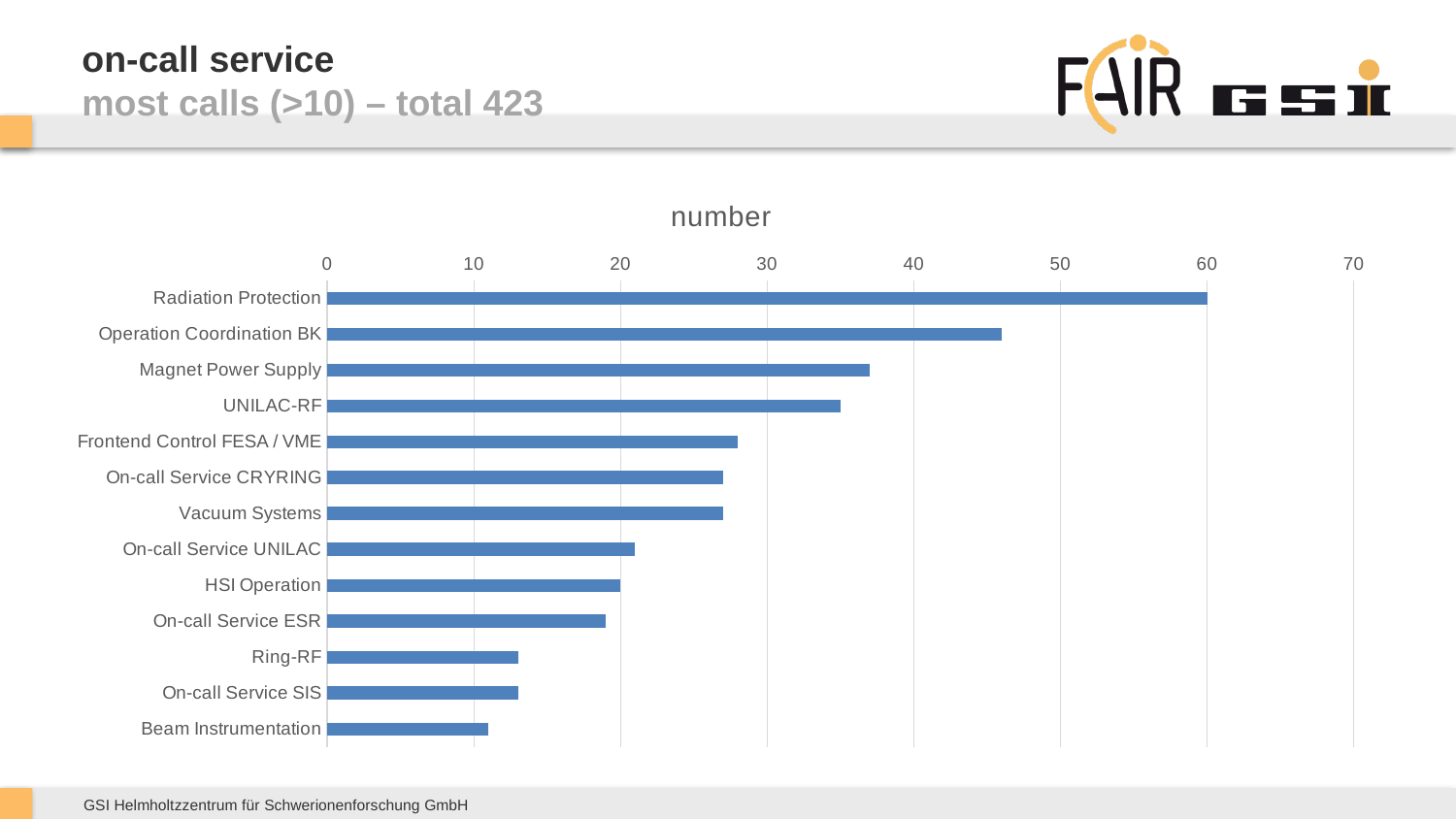
What is the title of the chart? number Is the value for Operation Coordination BK greater or less than 40? greater What kind of chart is shown on the slide? bar chart How many categories are plotted in the chart? 13 Which category has the lowest number of calls? Beam Instrumentation Do the bar values increase or decrease going from the top category to the bottom category? decrease Which category has the highest number of calls? Radiation Protection What is the value for Radiation Protection? 60 Is the value for Magnet Power Supply greater or less than 40? less Is the value for UNILAC-RF greater or less than 30? greater Which is larger, the value for Operation Coordination BK or the value for Magnet Power Supply? Operation Coordination BK